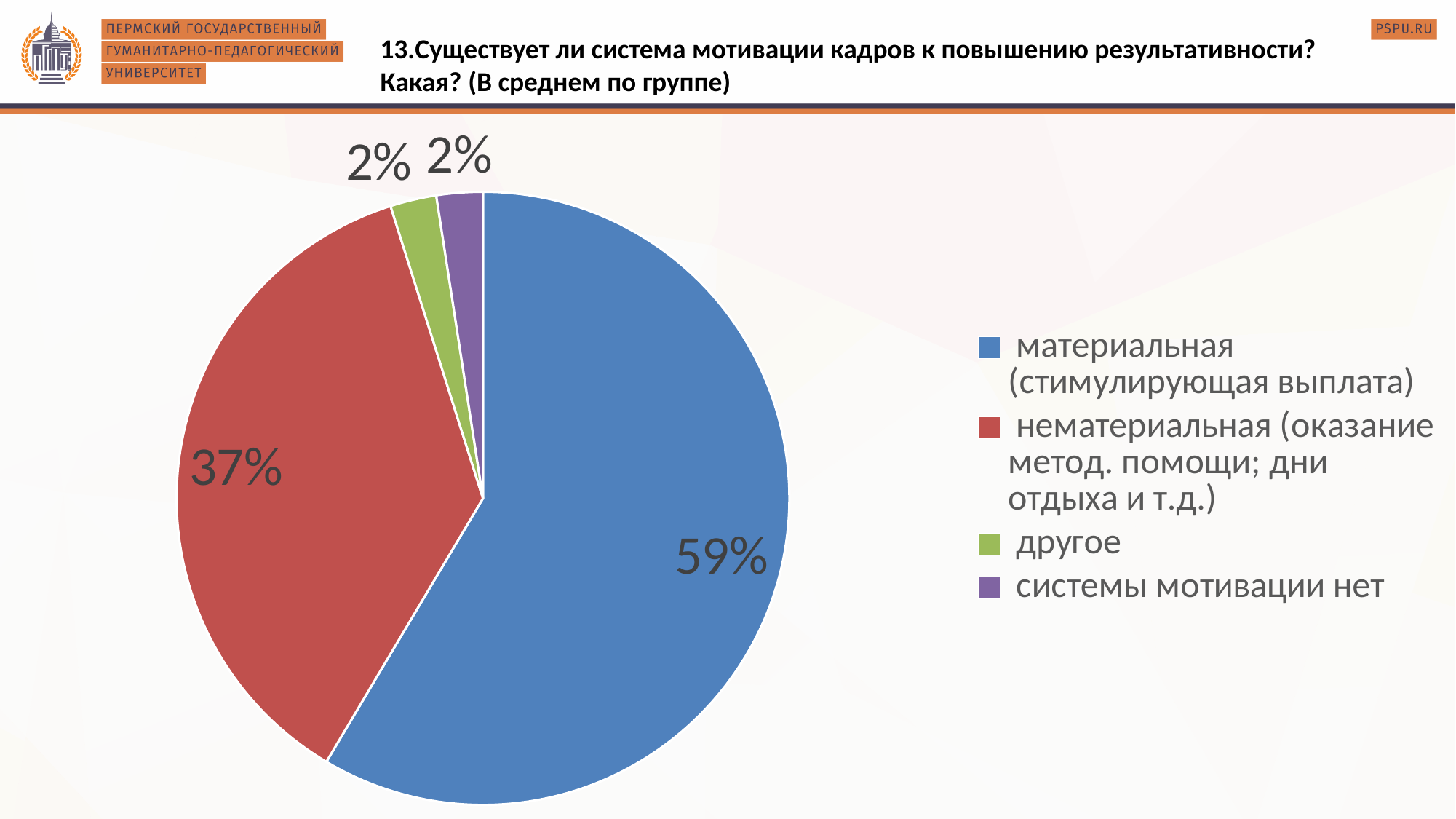
What type of chart is shown on the slide? pie chart What share of the pie does "материальная (стимулирующая выплата)" have? 59% What share of the pie does "системы мотивации нет" have? 2% What share of the pie does "нематериальная (оказание метод. помощи; дни отдыха и т.д.)" have? 37% Which category has the largest slice of the pie? материальная (стимулирующая выплата) Which is larger: the share for "нематериальная (оказание метод. помощи; дни отдыха и т.д.)" or the share for "другое"? нематериальная (оказание метод. помощи; дни отдыха и т.д.) How many entries does the legend list? 4 What colour is the slice for "системы мотивации нет"? purple How many categories does the pie chart have? 4 What colour is the slice for "другое"? green What is the difference between the shares of "материальная (стимулирующая выплата)" and "нематериальная (оказание метод. помощи; дни отдыха и т.д.)"? 22%